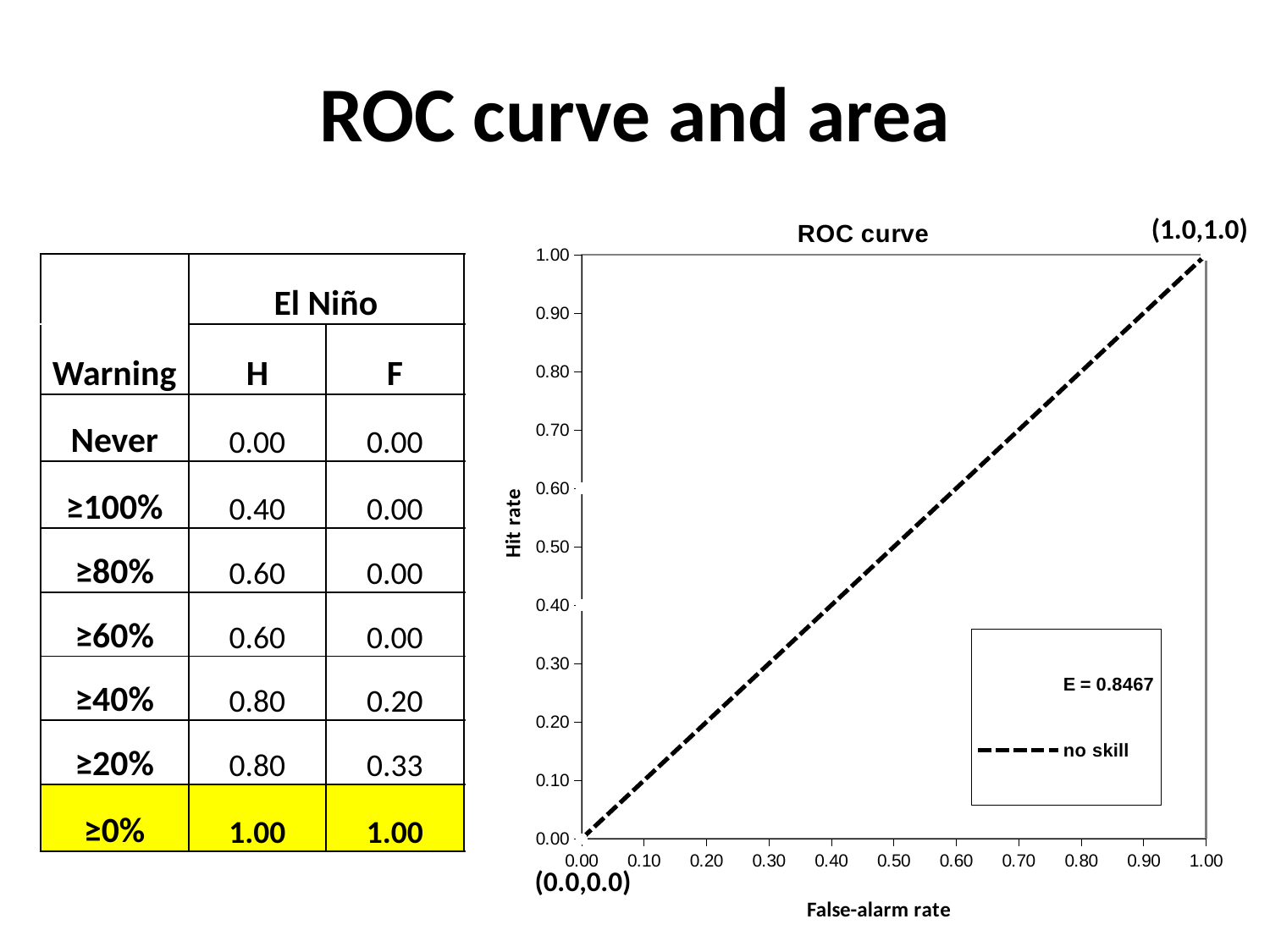
On the 'no skill' line, is the hit rate larger at a false-alarm rate of 0.20 or at 0.80? 0.80 Does the 'no skill' line rise or fall as the false-alarm rate increases? rises What value of E is given in the chart's legend? E = 0.8467 What is the hit rate of the 'no skill' line at a false-alarm rate of 0.00, as annotated on the chart? 0.0 Is the hit rate of the 'no skill' line at a false-alarm rate of 0.50 greater or less than 0.80? less What is the title of the chart? ROC curve How many entries does the chart's legend list? 2 What kind of chart is shown on the slide? line chart Is the hit rate of the 'no skill' line at a false-alarm rate of 0.90 greater or less than 0.50? greater What is the hit rate of the 'no skill' line at a false-alarm rate of 1.00, as annotated on the chart? 1.0